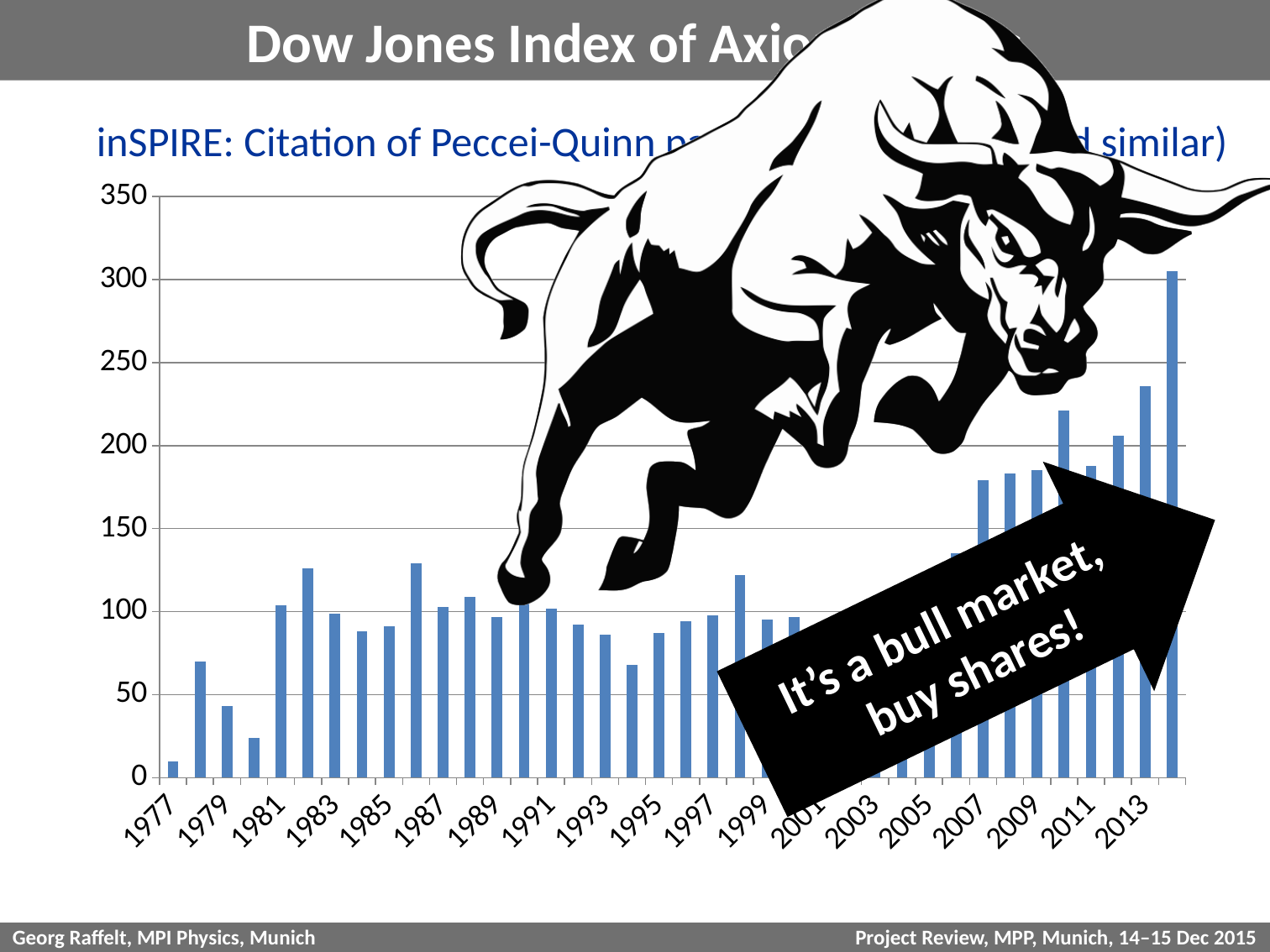
Is the value for 1994 greater or less than 100? less Which year has the highest bar in the chart? 2014 Which is larger, the value for 1980 or the value for 1982? 1982 Which year has the lowest bar in the chart? 1977 What is the highest value shown on the vertical axis? 350 Which is larger, the value for 1994 or the value for 1998? 1998 Is the value for 2014 greater or less than 250? greater What kind of chart is shown on the slide? bar chart Is the value for 1982 greater or less than 100? greater Do the values generally rise or fall from 2007 to 2014? rise